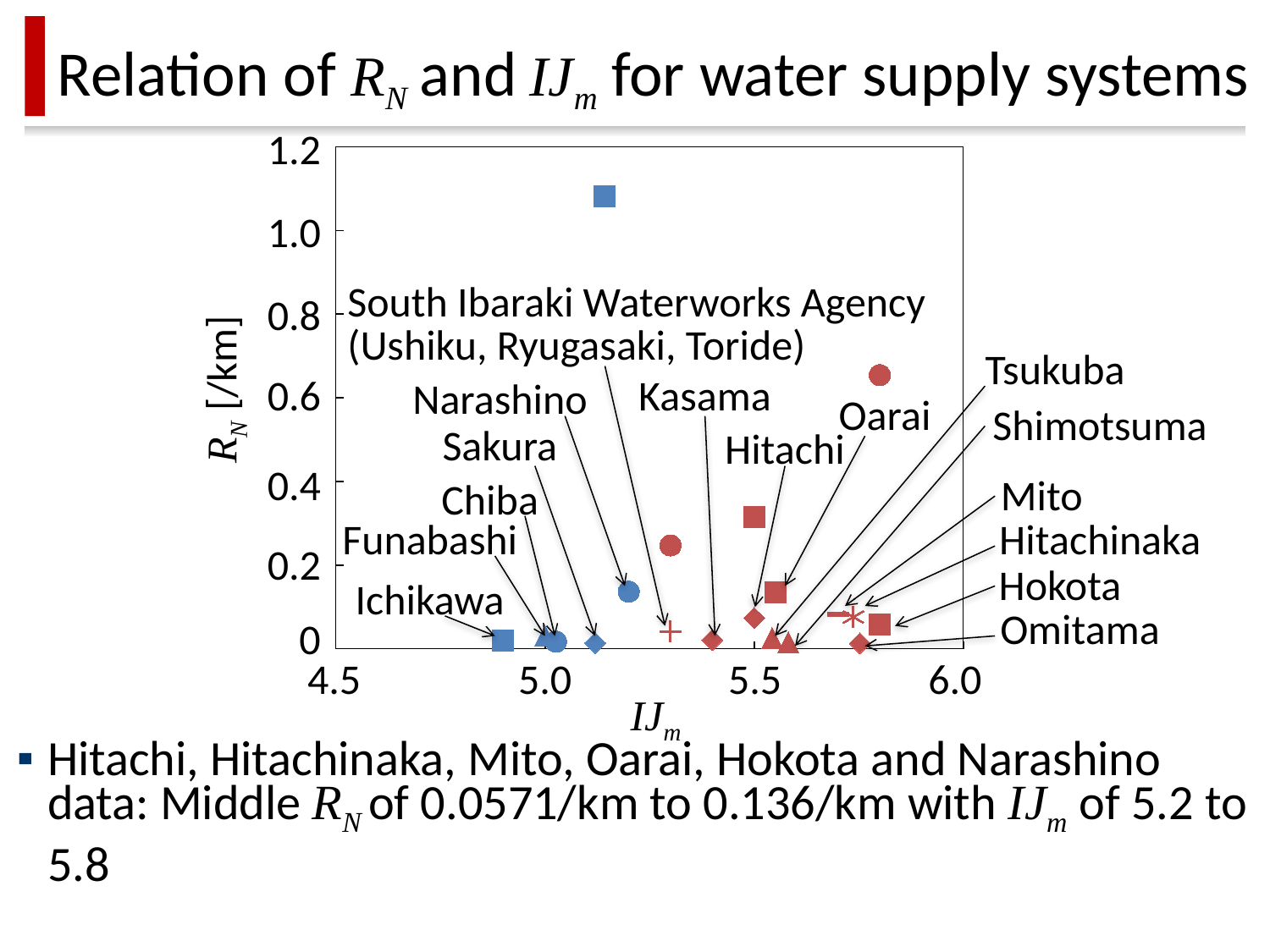
Is the IJ_m value for Hokota greater or less than 5.5? greater What kind of chart is shown on the slide? scatter chart Which has the larger R_N value, Oarai or Ichikawa? Oarai What is the label of the y axis of the chart? R_N [/km] Is the R_N value of the highest point on the chart greater or less than 1.0? greater Is the IJ_m value for Sakura greater or less than 5.0? greater Which has the larger IJ_m value, Hokota or Ichikawa? Hokota What is the label of the x axis of the chart? IJ_m